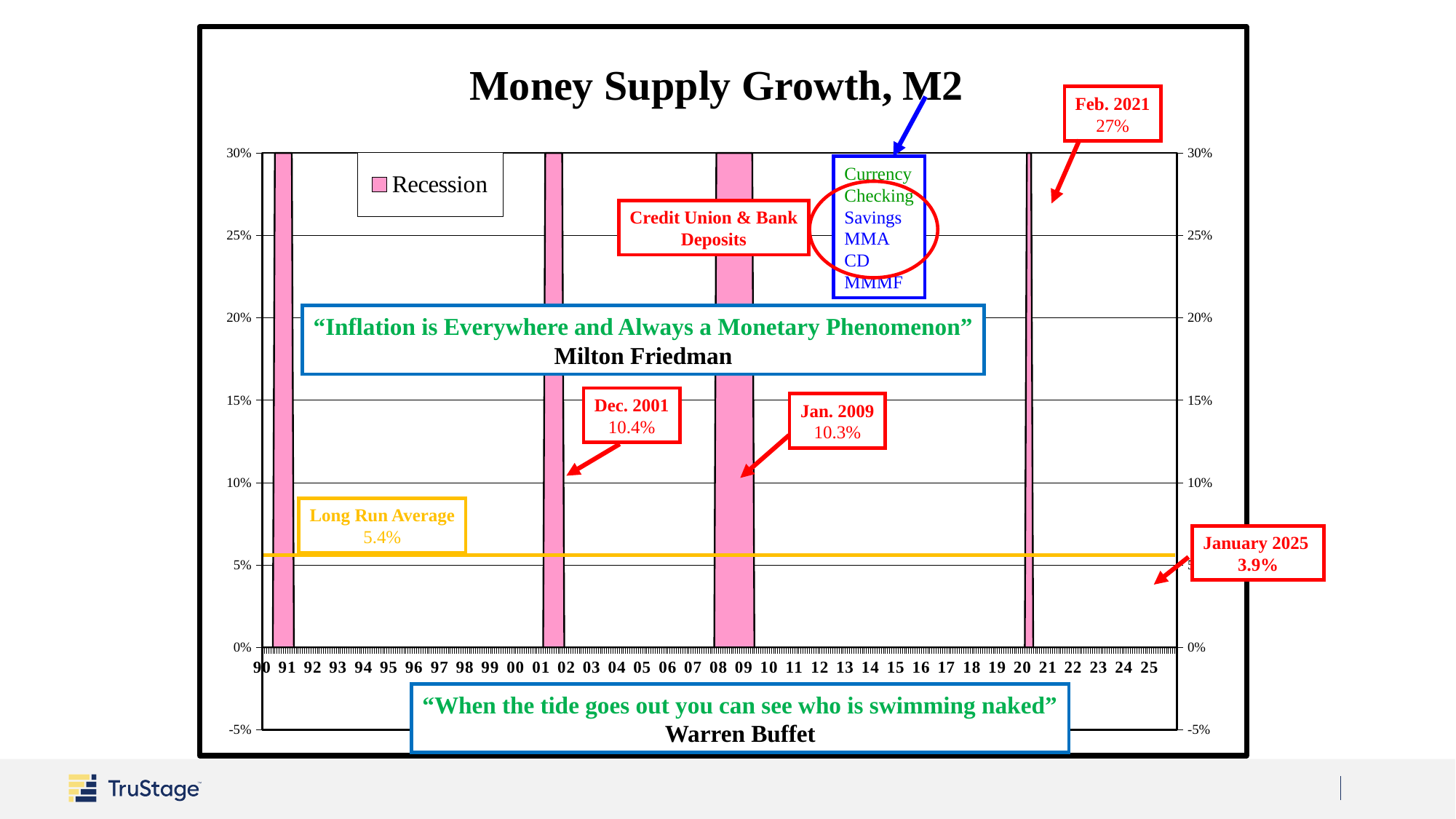
What entry does the chart legend list? Recession How many shaded recession periods are shown on the chart? 4 What is the Long Run Average of M2 growth shown on the chart? 5.4% What is the title of the chart? Money Supply Growth, M2 Is the annotated Dec. 2001 value larger or smaller than the Jan. 2009 value? larger Which annotated date has the highest M2 growth value? Feb. 2021 Which annotated date has the lowest M2 growth value? January 2025 What is the difference between the Feb. 2021 value and the January 2025 value? 23.1% What M2 growth value is annotated for January 2025? 3.9% What M2 growth value is annotated for Jan. 2009? 10.3% What M2 growth value is annotated for Dec. 2001? 10.4% What M2 growth value is annotated for Feb. 2021? 27%